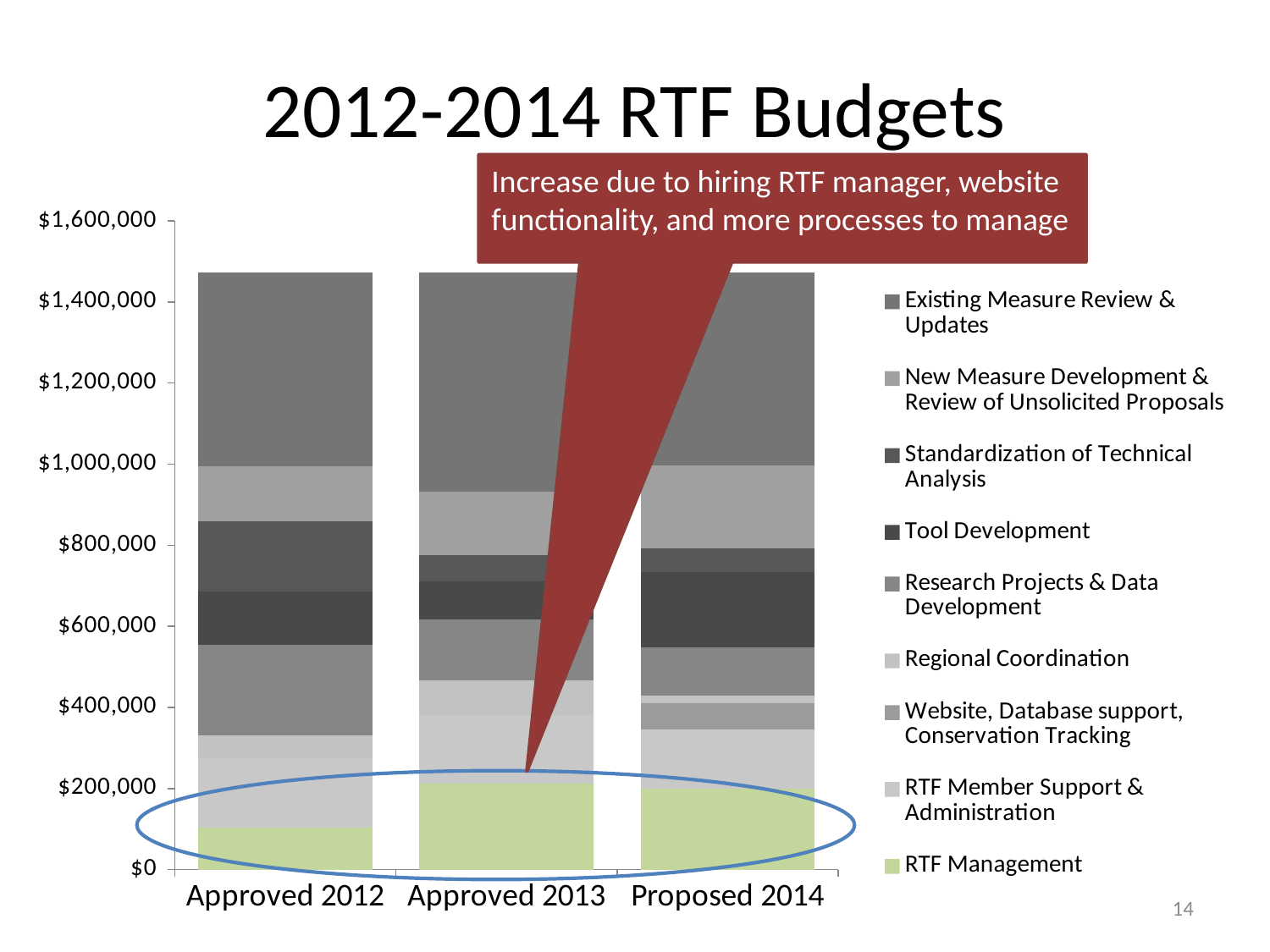
How many series does the legend list? 9 Is the total budget for Approved 2012 greater or less than $1,400,000? greater What is the label of the third category on the x axis? Proposed 2014 Which budget year has the lowest RTF Management value? Approved 2012 Is the total budget for Proposed 2014 greater or less than $1,600,000? less How many budget years (categories) are shown on the x axis? 3 Is the RTF Management value for Approved 2012 greater or less than $200,000? less Which is larger, the RTF Management value for Approved 2012 or for Approved 2013? Approved 2013 Which legend entry is shown in green at the bottom of the stacked bars? RTF Management What is the title of the chart? 2012-2014 RTF Budgets What kind of chart is shown on the slide? Stacked bar chart